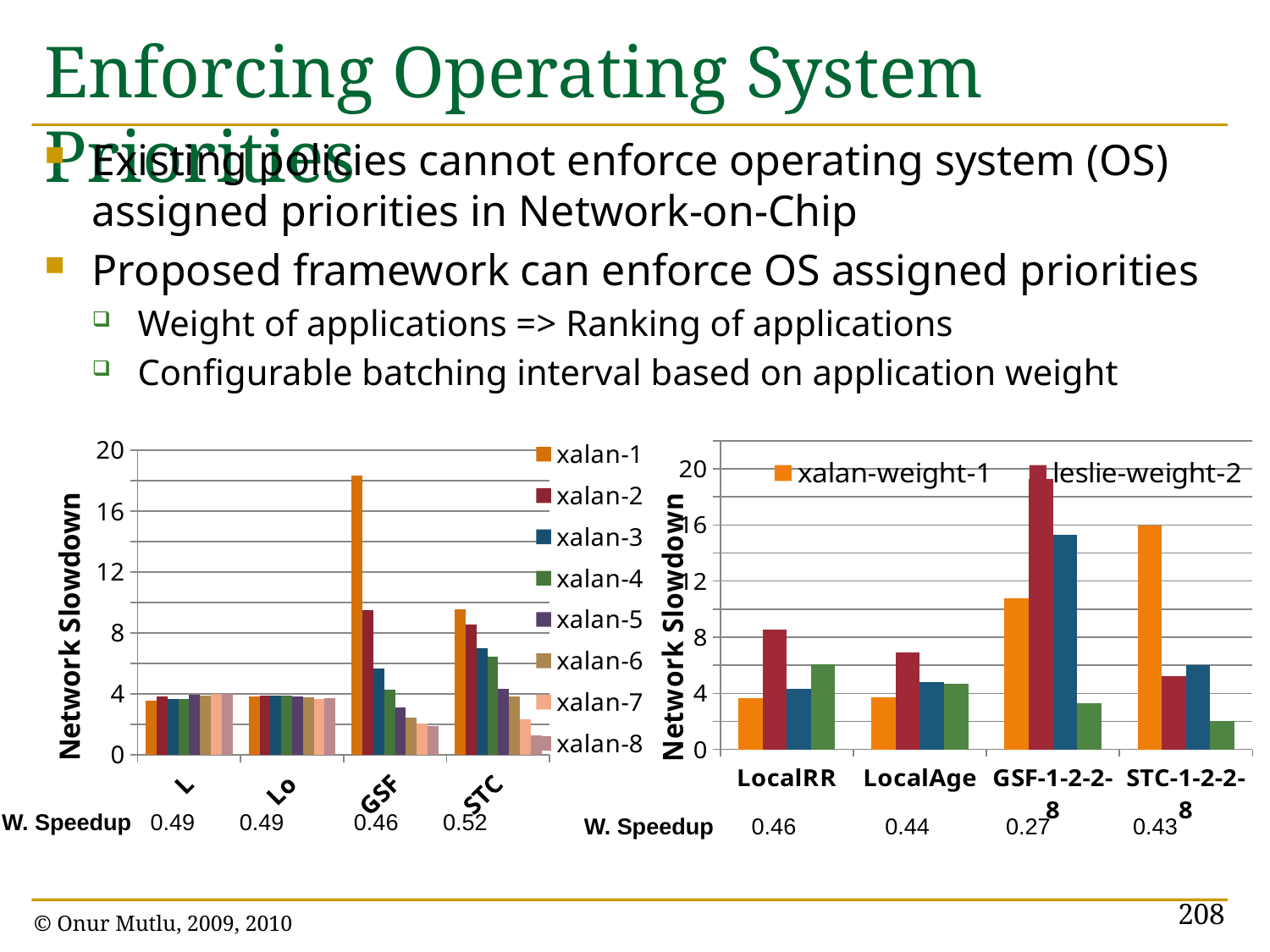
What W. Speedup value is printed under GSF-1-2-2-8 in the right chart? 0.27 How many categories are shown on the x axis of the right chart? 4 In the right chart, does the xalan-weight-1 value rise or fall from LocalRR to STC-1-2-2-8? rise In the right chart, which category has the highest xalan-weight-1 value? STC-1-2-2-8 In the right chart, for GSF-1-2-2-8, which is larger: xalan-weight-1 or leslie-weight-2? leslie-weight-2 In the right chart, is the value of leslie-weight-2 for GSF-1-2-2-8 greater or less than 16? greater What kind of chart is the left chart on the slide? bar chart What is the y-axis label of the right chart? Network Slowdown How many series does the legend of the left chart list? 8 In the left chart, is the value of xalan-1 for GSF greater or less than 16? greater In the right chart, is the value of xalan-weight-1 for GSF-1-2-2-8 greater or less than 8? greater